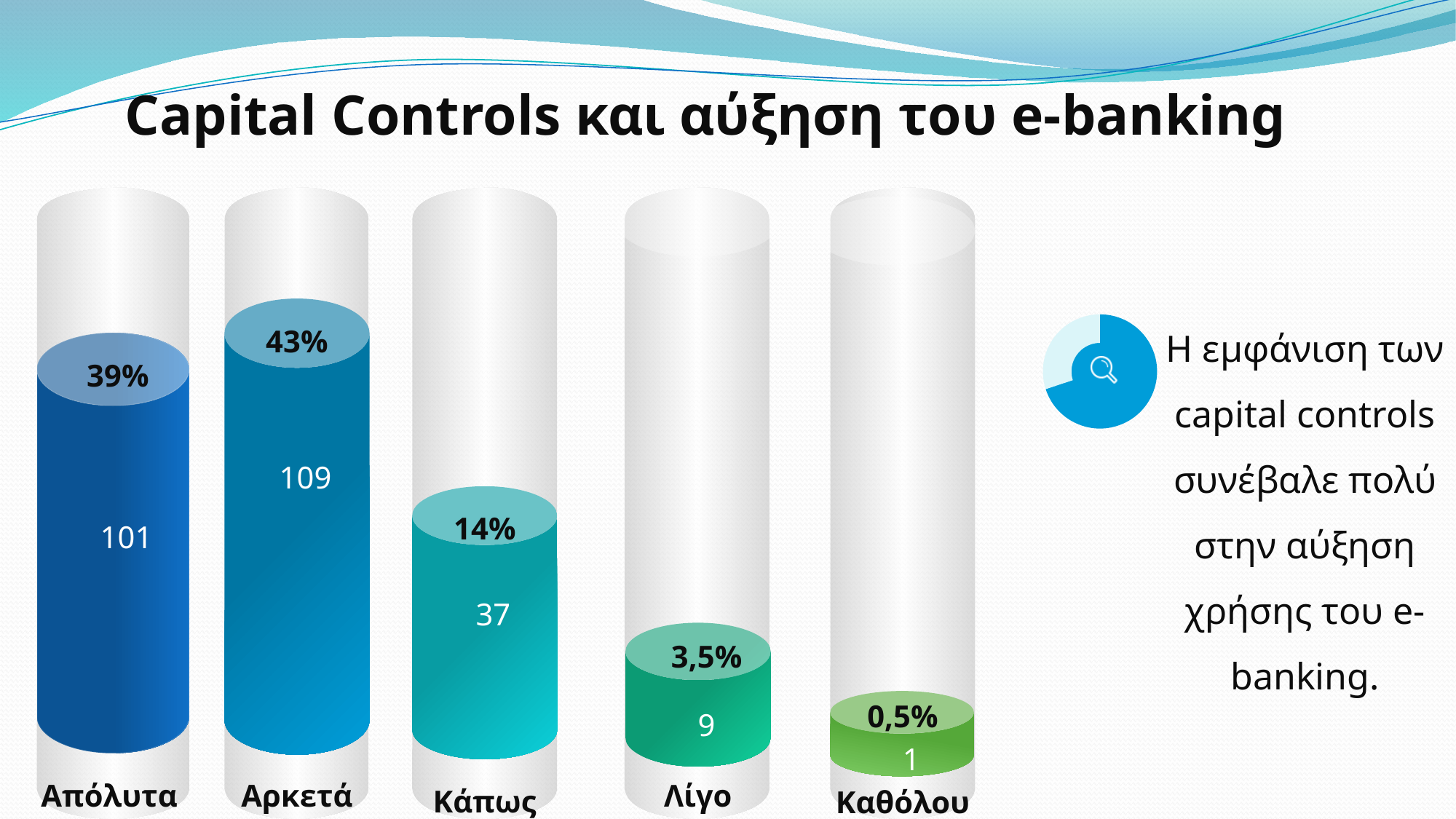
What is the count shown for the "Απόλυτα" bar? 101 What is the title of the slide? Capital Controls και αύξηση του e-banking What is the count shown for the "Καθόλου" bar? 1 Which category has the highest value? Αρκετά Which is larger, the count for "Κάπως" or the count for "Λίγο"? Κάπως What percentage is shown for the "Αρκετά" bar? 43% What is the count shown for the "Κάπως" bar? 37 Which category has the lowest value? Καθόλου How many categories are shown in the chart? 5 What is the difference in count between "Αρκετά" and "Απόλυτα"? 8 What percentage is shown for the "Λίγο" bar? 3,5% What kind of chart is shown on the slide? Bar chart